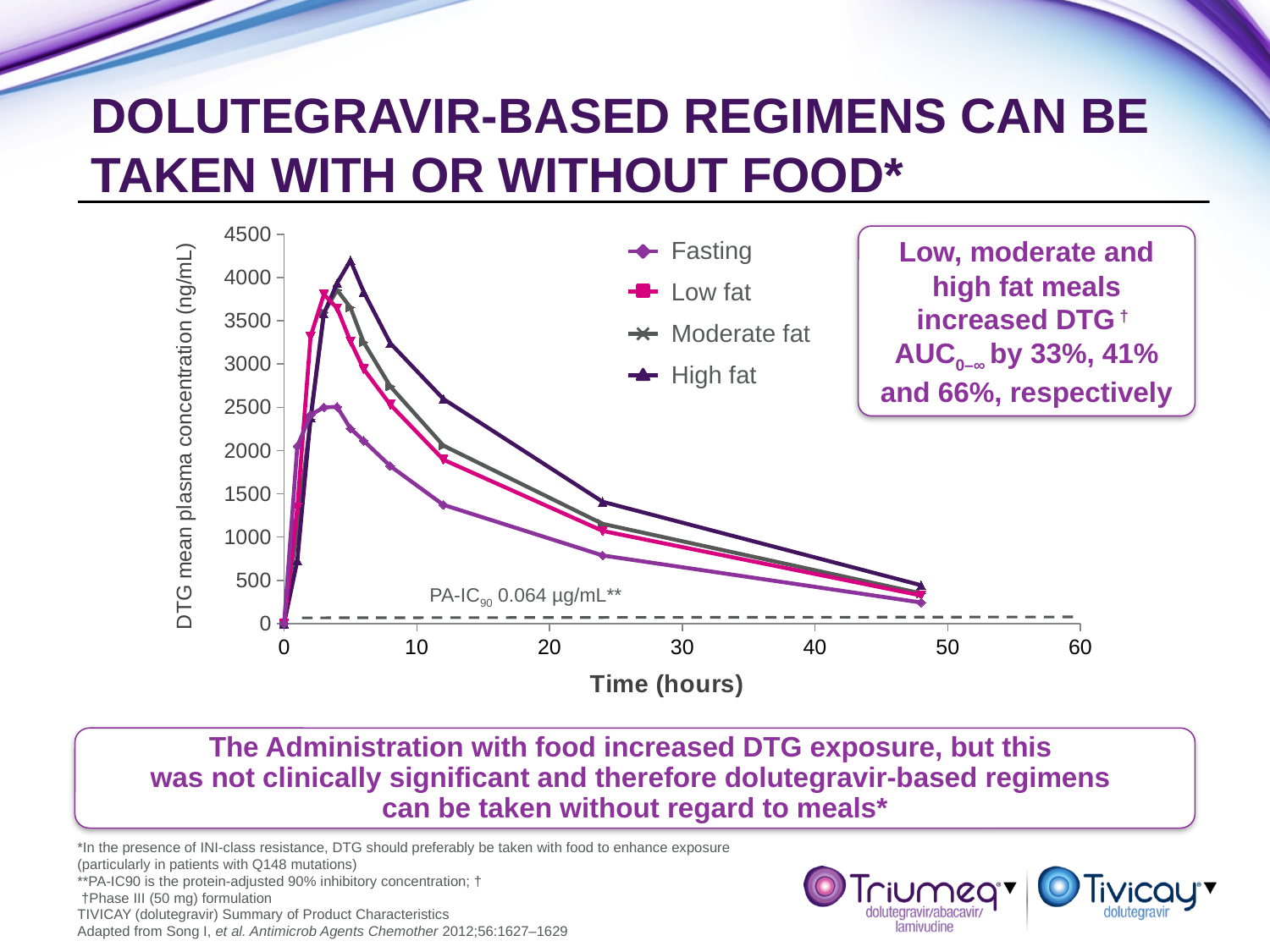
Is the Fasting value at 24 hours greater or less than 1000 ng/mL? less At 24 hours, which series has the higher concentration, High fat or Fasting? High fat Is the peak value for the Moderate fat series greater or less than 3500 ng/mL? greater Is the peak value for the Fasting series greater or less than 3000 ng/mL? less Which series reaches the highest peak DTG mean plasma concentration? High fat After reaching their peaks, do the concentrations for all series rise or fall as time increases toward 48 hours? fall How many series does the chart legend list? 4 What value does the dashed horizontal reference line on the chart represent? PA-IC90 0.064 µg/mL What is the label on the y axis of the chart? DTG mean plasma concentration (ng/mL) What kind of chart is shown on the slide? Line chart Which series has the lowest peak DTG mean plasma concentration? Fasting